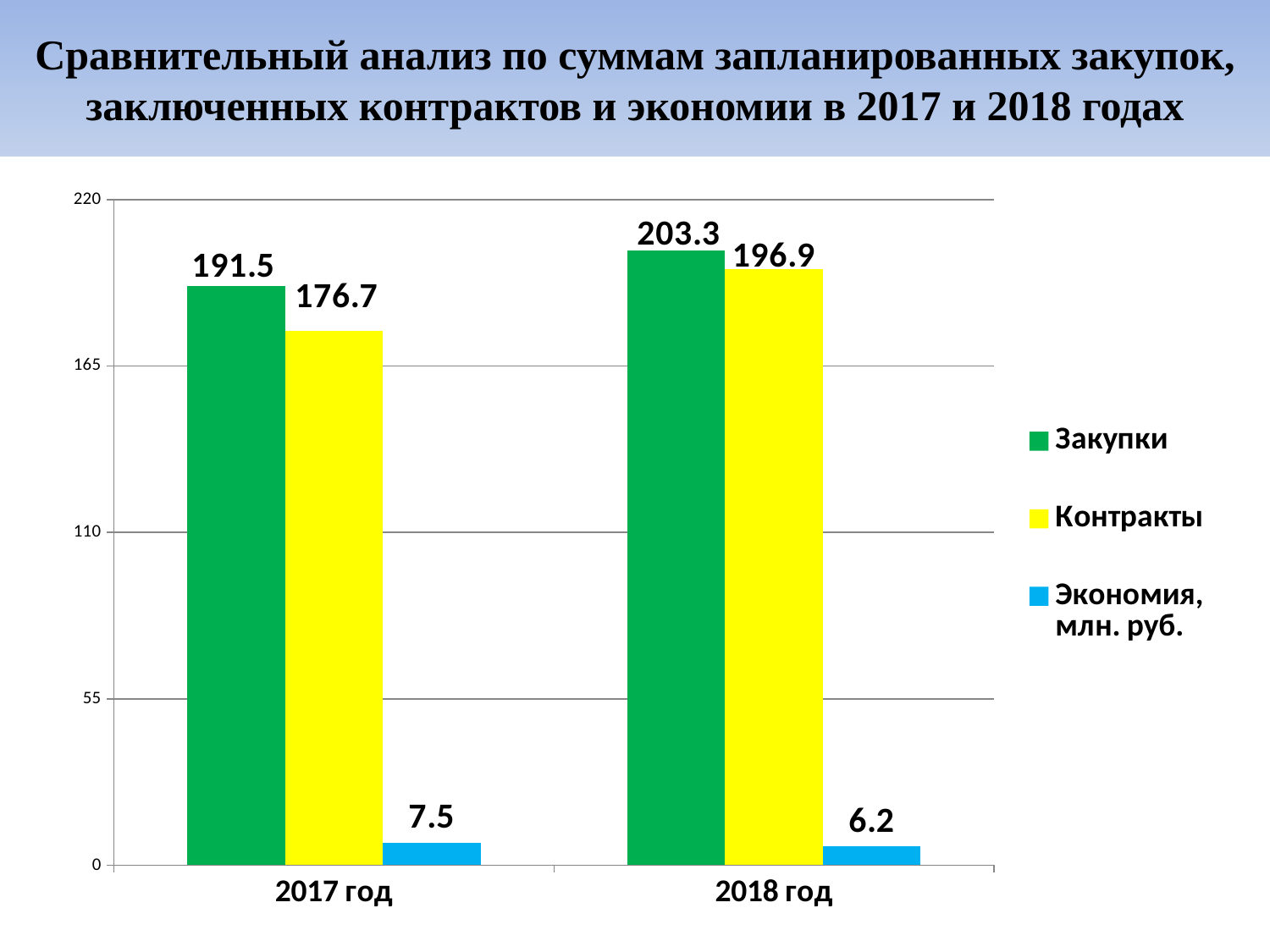
Which year has the lower value for Экономия, млн. руб.? 2018 год What is the value of Контракты for 2018 год? 196.9 What kind of chart is shown on the slide? bar chart Is the value of Контракты for 2017 год greater or less than 165? greater Does the value of Экономия, млн. руб. rise or fall from 2017 год to 2018 год? fall What is the value of Экономия, млн. руб. for 2017 год? 7.5 What is the difference between Закупки in 2018 год and Закупки in 2017 год? 11.8 What is the difference between Закупки and Контракты in 2017 год? 14.8 Which is larger: Контракты in 2018 год or Закупки in 2017 год? Контракты in 2018 год How many series does the legend list? 3 What is the value of Закупки for 2017 год? 191.5 Which year has the higher value for Закупки? 2018 год